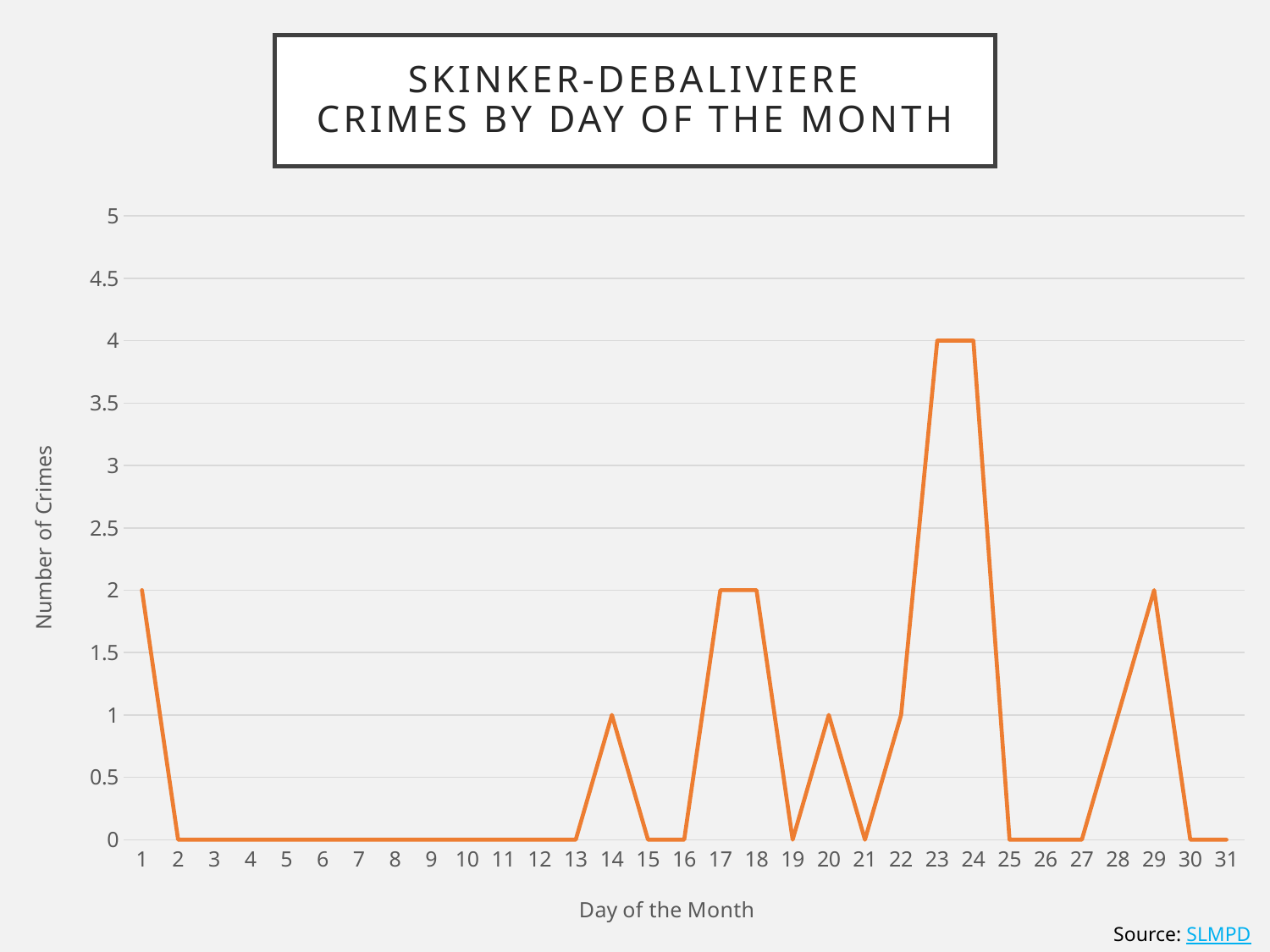
How many days of the month are shown on the x axis? 31 On which days does the number of crimes reach its highest value? 23 and 24 What is the difference between the number of crimes on day 24 and on day 20? 3 Which day has more crimes, day 17 or day 14? day 17 What is the number of crimes on day 29? 2 Is the number of crimes on day 23 greater or less than 3? greater What is the number of crimes on day 1? 2 What is the number of crimes on day 14? 1 What is the number of crimes on day 23? 4 What is the label of the y axis? Number of Crimes What type of chart is shown on the slide? line chart What is the title of the chart? SKINKER-DEBALIVIERE CRIMES BY DAY OF THE MONTH